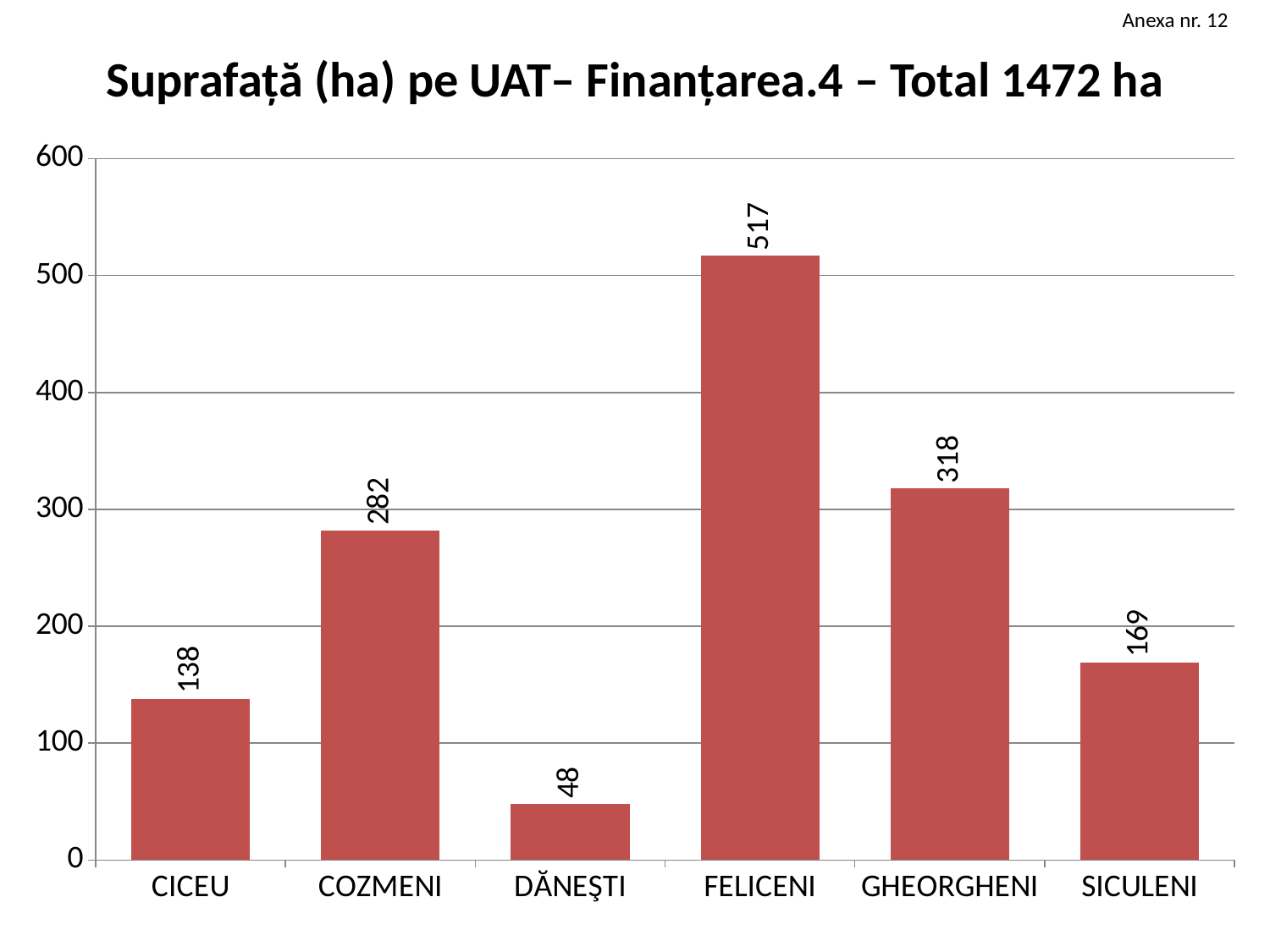
Is the value for COZMENI greater or less than 300? less What is the difference between the values for COZMENI and CICEU? 144 What is the difference between the values for FELICENI and GHEORGHENI? 199 What is the value for CICEU? 138 What is the value for SICULENI? 169 What total is stated in the chart title? 1472 ha Which UAT has the lowest value? DĂNEŞTI Which UAT has the highest value? FELICENI What kind of chart is shown on the slide? bar chart What is the value for FELICENI? 517 How many UATs are shown on the chart? 6 Which is larger, the value for GHEORGHENI or the value for COZMENI? GHEORGHENI